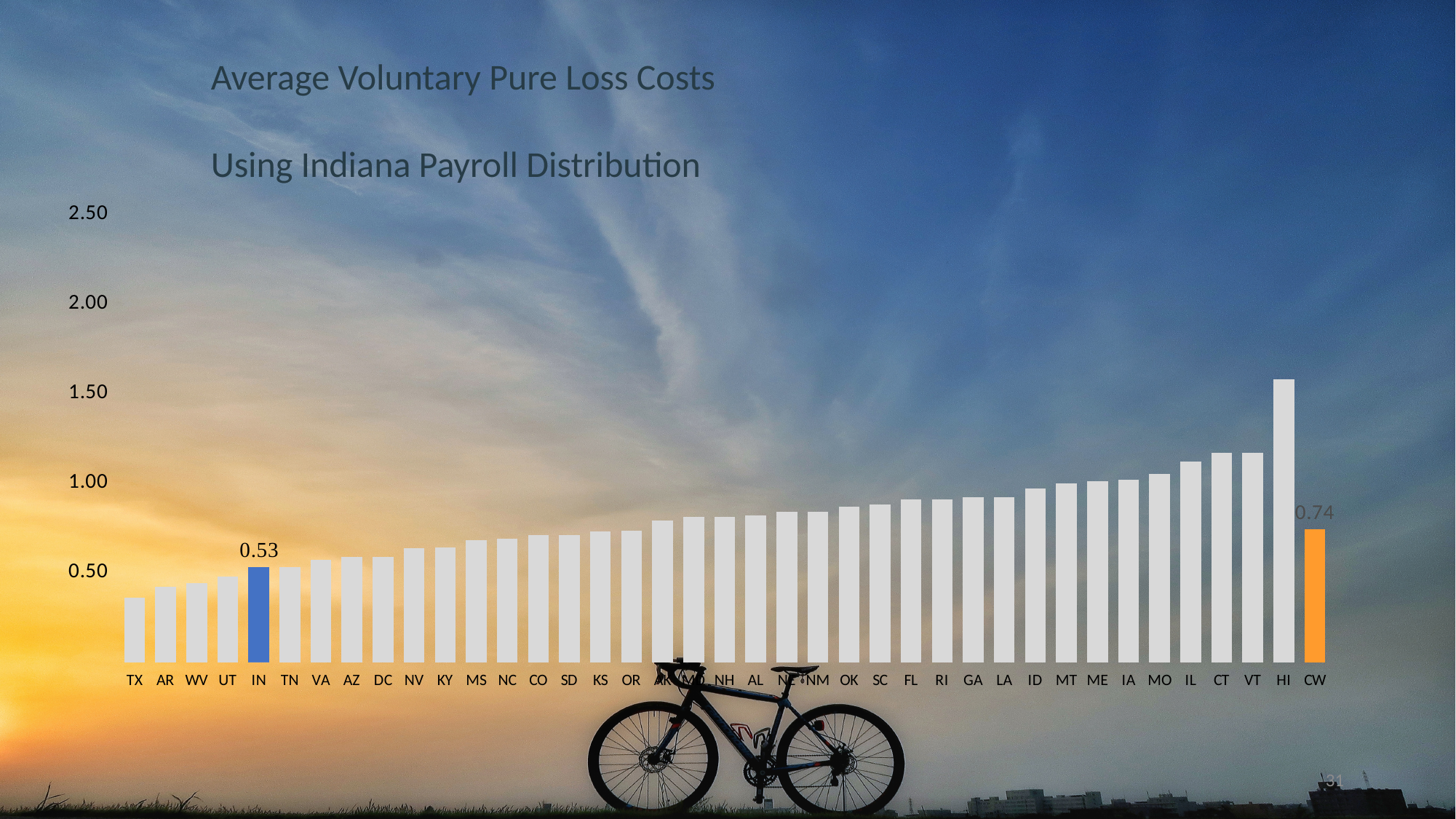
Which state has the highest average voluntary pure loss cost? HI What is the difference between the values for CW and IN? 0.21 Is the value for OK greater or less than 1.00? less What is the value for IN? 0.53 Which is larger, the value for CW or the value for IN? CW Is the value for TX greater or less than 0.50? less Which state has the lowest average voluntary pure loss cost? TX What is the value for CW? 0.74 What kind of chart is shown on the slide? bar chart What colour is the bar for IN? blue Is the value for HI greater or less than 1.50? greater Which is larger, the value for HI or the value for VT? HI